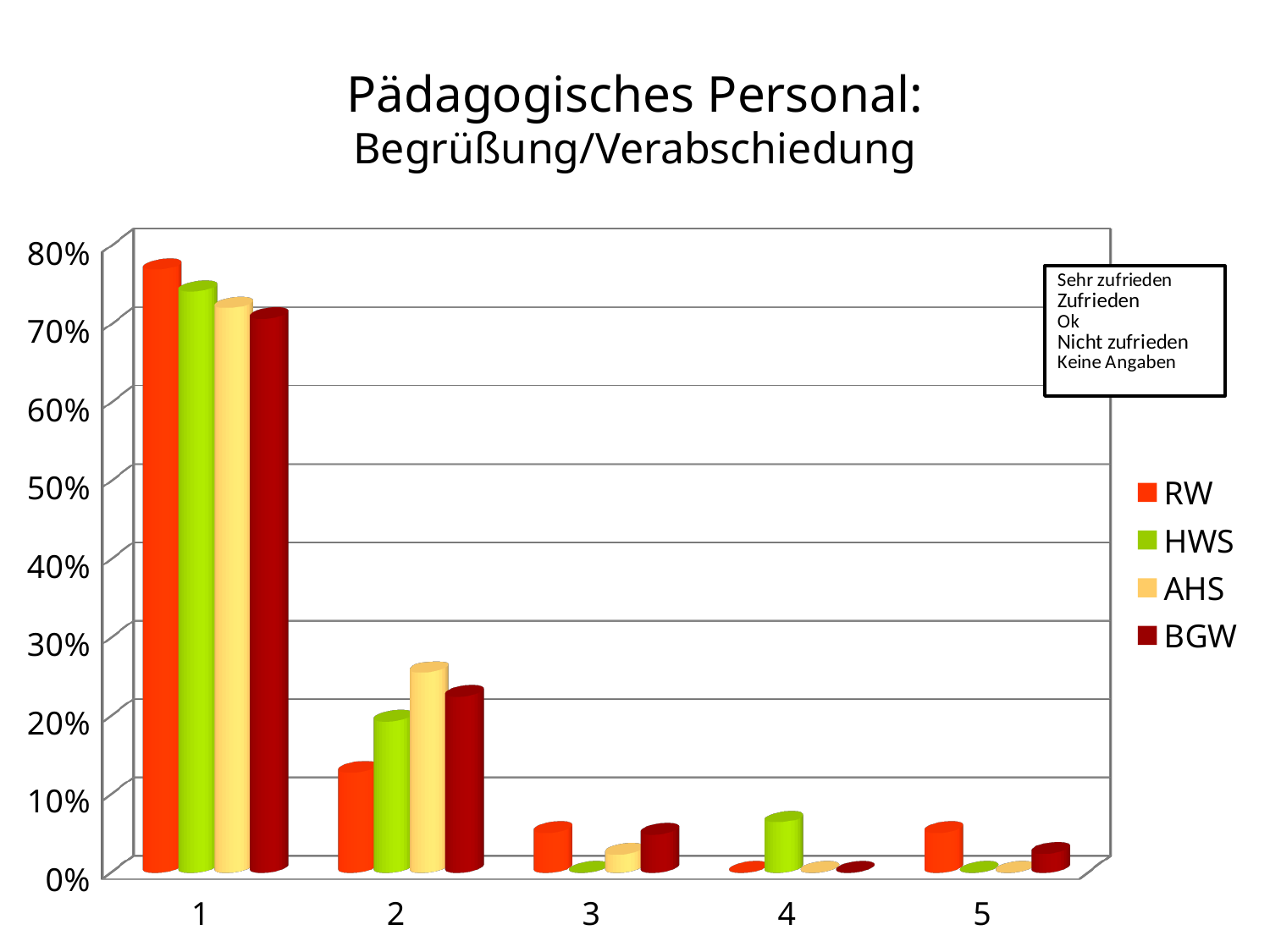
What kind of chart is shown on the slide? bar chart How many series does the legend list? 4 Is the value for RW in category 2 greater or less than 20%? less Is the value for AHS in category 2 greater or less than 20%? greater How many categories are shown on the x axis? 5 What is the title of the chart? Pädagogisches Personal: Begrüßung/Verabschiedung Which is larger in category 2, the value for RW or the value for HWS? HWS Which series has the highest value in category 4? HWS Which category has the highest values for all series? 1 Is the value for RW in category 1 greater or less than 70%? greater Which series has the highest value in category 2? AHS Which series are listed in the legend? RW, HWS, AHS, BGW